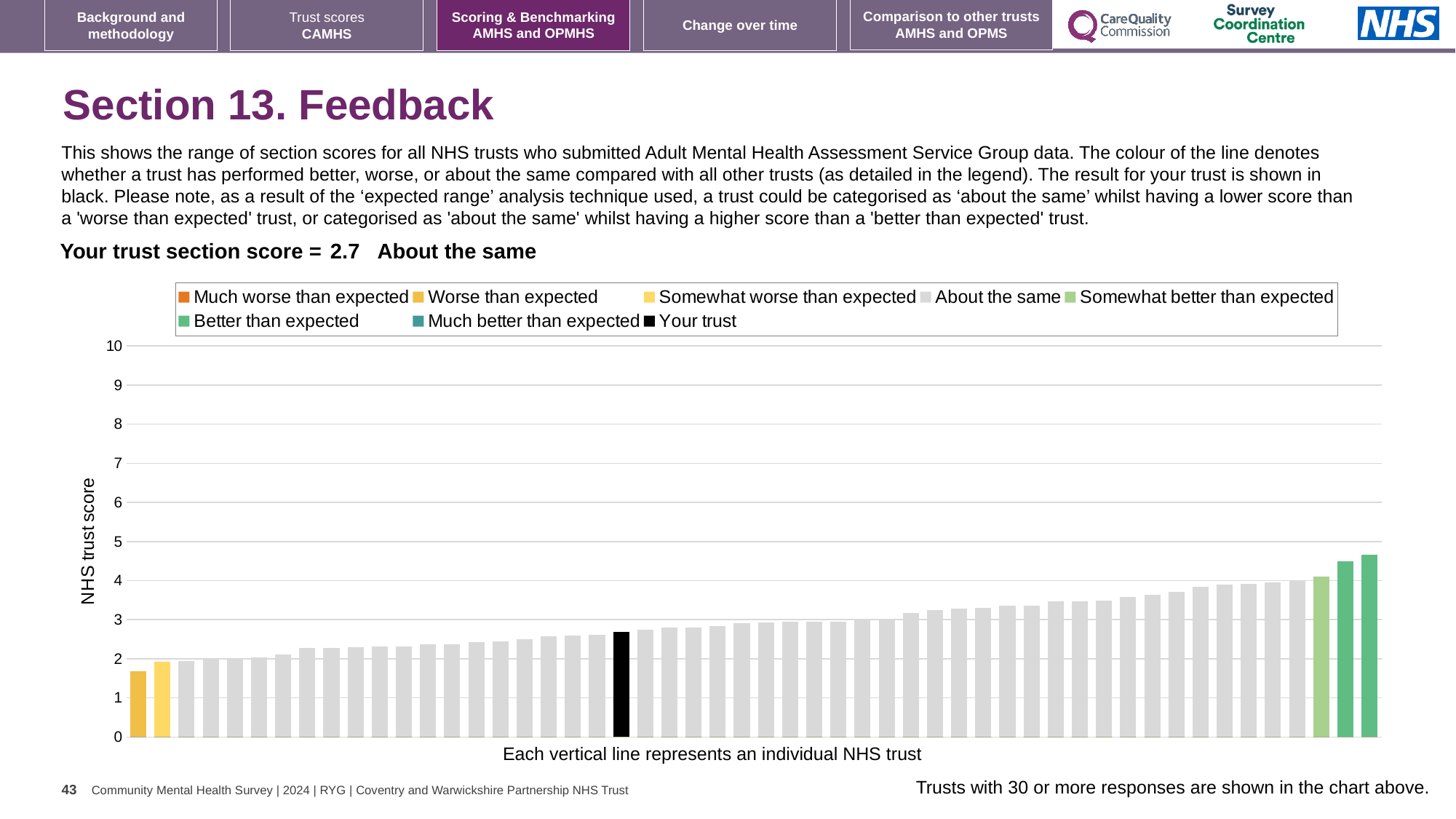
How is your trust's section score categorised compared with other trusts? About the same Is the value of the tallest bar in the chart greater or less than 4? greater Is the value of the shortest bar in the chart greater or less than 2? less How many trusts are shown with the 'Better than expected' colour? 2 What is the title of the vertical axis? NHS trust score Do the bar values rise or fall from left to right along the x axis? rise Is the value of the black 'Your trust' bar greater or less than 3? less What kind of chart is shown on the slide? bar chart What is the highest value shown on the vertical axis? 10 What is the section score for your trust? 2.7 What colour is the bar representing your trust? black How many entries does the chart legend list? 8